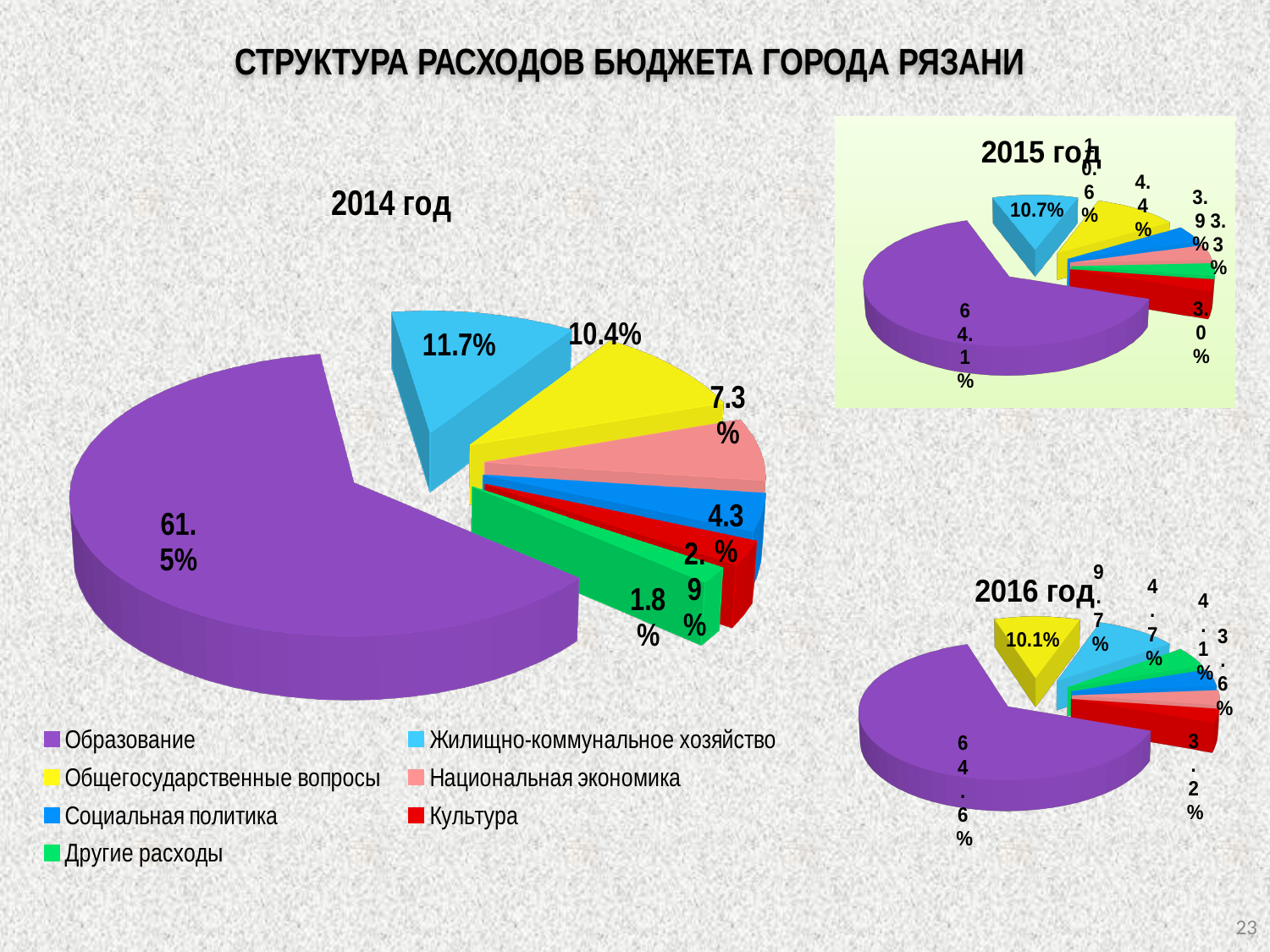
On the 2016 год chart, what share does Образование have? 64.6% On the 2015 год chart, what share does Образование have? 64.1% On the 2014 год chart, what is the difference between Жилищно-коммунальное хозяйство and Общегосударственные вопросы? 1.3% On the 2014 год chart, which category has the smallest share? Другие расходы On the 2014 год chart, what is the value for Общегосударственные вопросы? 10.4% On the 2014 год chart, what is the value for Национальная экономика? 7.3% How many categories does the legend list? 7 What type of chart is used for the 2014 год data? Pie chart On the 2014 год chart, what is the value for Жилищно-коммунальное хозяйство? 11.7% On the 2014 год chart, which is larger: Социальная политика or Культура? Социальная политика On the 2014 год chart, which category has the largest share? Образование On the 2014 год chart, what share does Образование have? 61.5%